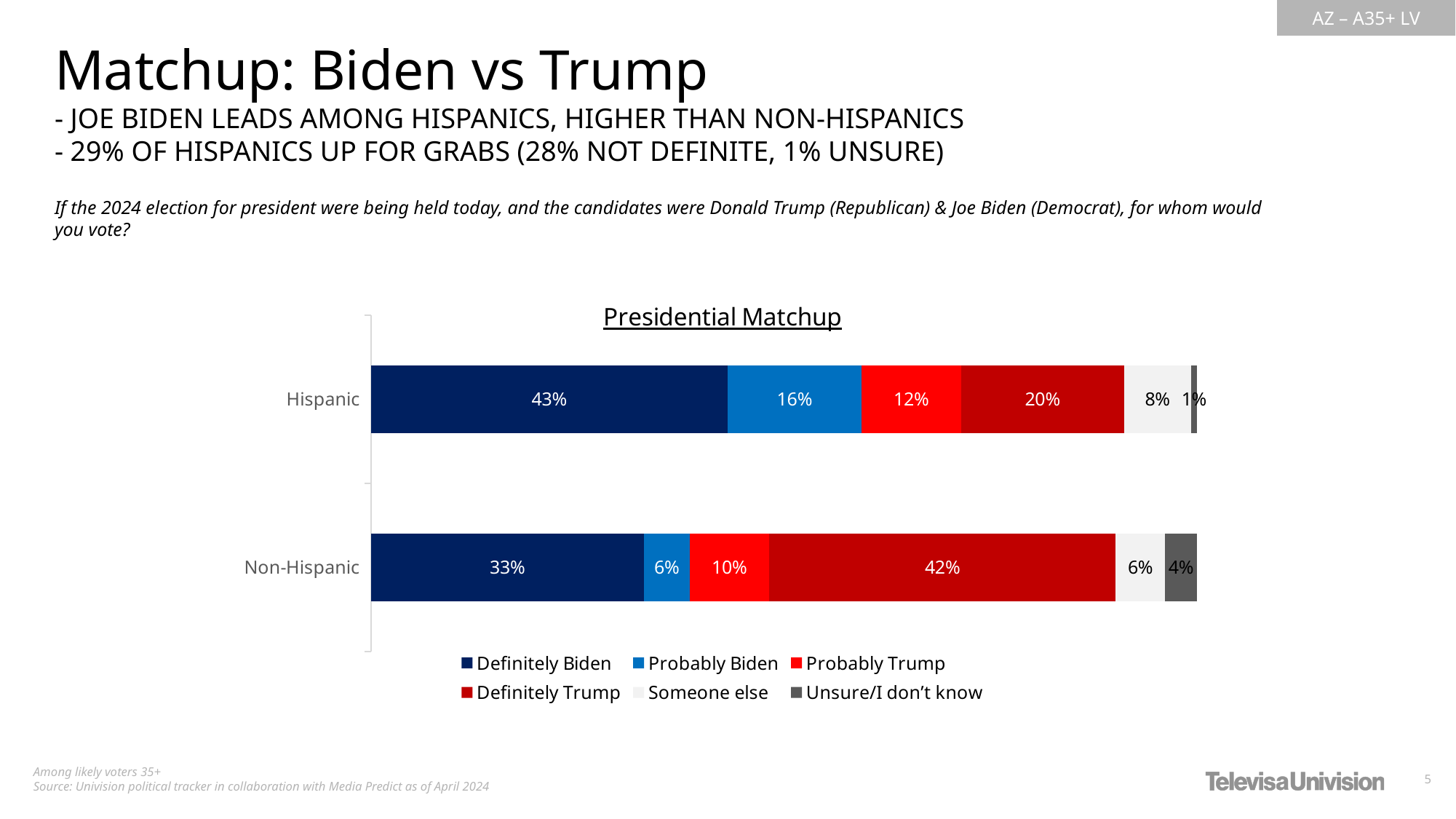
How many series does the legend list? 6 What is the title of the chart? Presidential Matchup Which legend entry is shown in dark grey? Unsure/I don't know What kind of chart is shown on the slide? Stacked bar chart What is the Probably Biden value for Non-Hispanic respondents? 6% What percentage of Hispanic respondents said Definitely Biden? 43% What is the Someone else value for Hispanic respondents? 8% How many categories are shown on the chart? 2 What is the difference between the Definitely Trump values for Non-Hispanic and Hispanic respondents? 22% What is the difference between the Probably Biden values for Hispanic and Non-Hispanic respondents? 10% Which category has the higher Definitely Biden value, Hispanic or Non-Hispanic? Hispanic What percentage of Non-Hispanic respondents said Definitely Trump? 42%